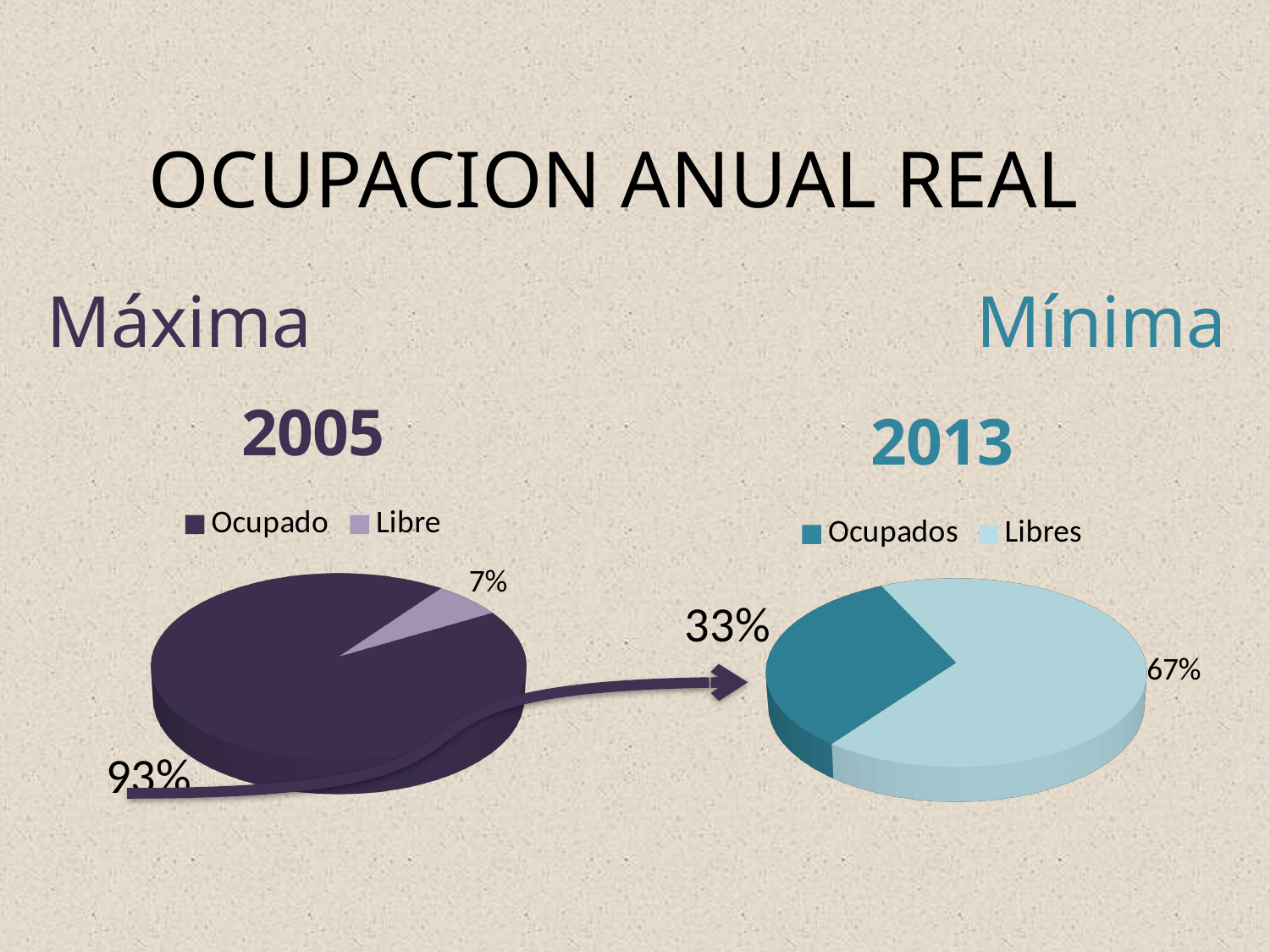
What is the title of the 2013 chart? 2013 In the 2005 chart, what percentage is Ocupado? 93% In the 2005 chart, which slice is the largest? Ocupado In the 2013 chart, which slice is the smallest? Ocupados In the 2013 chart, what percentage is Ocupados? 33% In the 2013 chart, what percentage is Libres? 67% Which is larger: Ocupado in the 2005 chart or Ocupados in the 2013 chart? Ocupado in the 2005 chart In the 2013 chart, what is the difference between the Libres and Ocupados percentages? 34% In the 2005 chart, what is the difference between the Ocupado and Libre percentages? 86% How many entries does the legend of the 2005 chart list? 2 What type of chart is the 2013 chart? Pie chart In the 2005 chart, what percentage is Libre? 7%